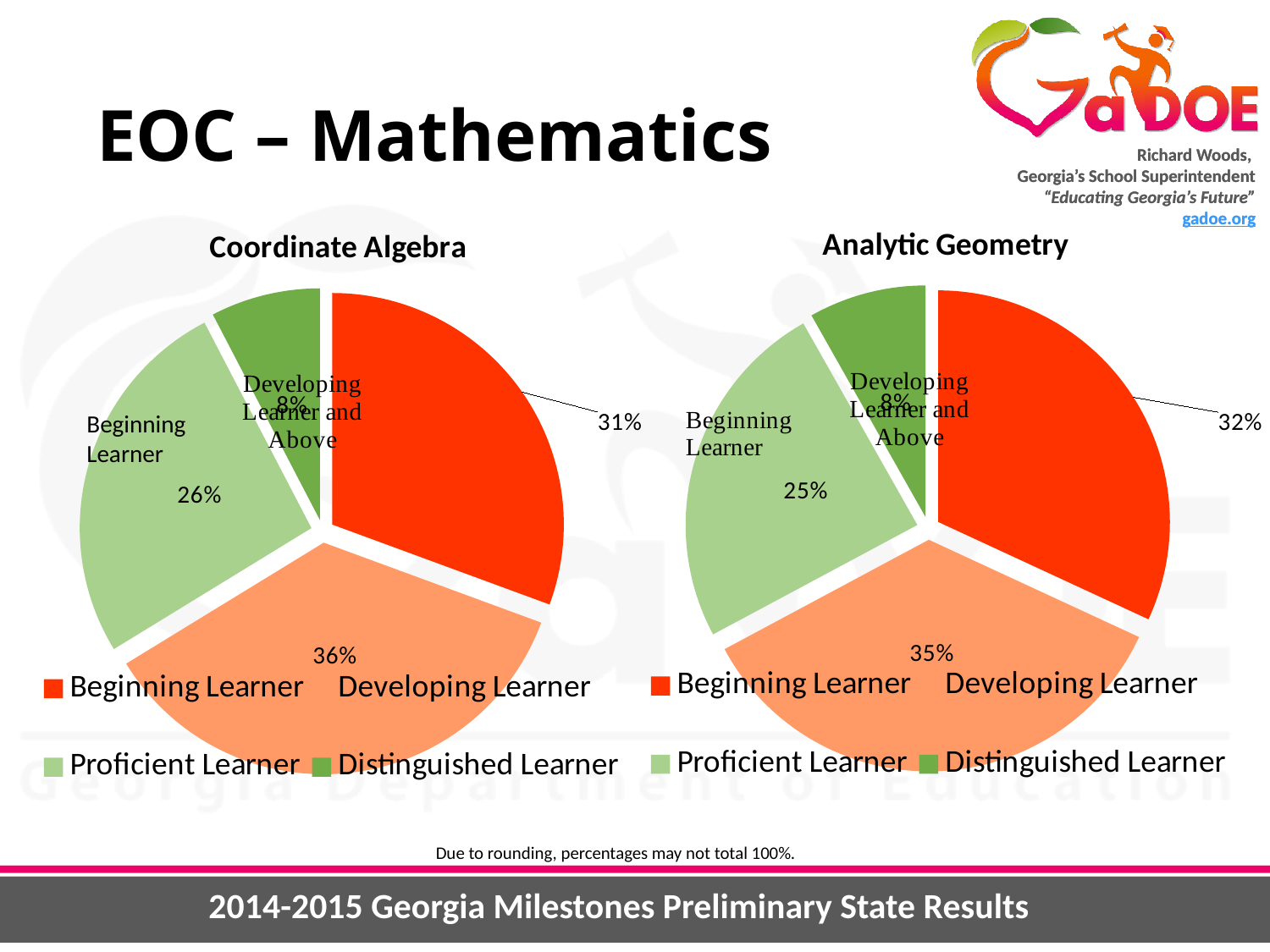
In the Coordinate Algebra chart, which category has the largest share? Developing Learner How many entries does the legend of the Coordinate Algebra chart list? 4 What type of chart is used for Coordinate Algebra? Pie chart How many categories does the Analytic Geometry chart show? 4 In the Coordinate Algebra chart, what is the difference between the Developing Learner and Proficient Learner percentages? 10% In the Analytic Geometry chart, what is the difference between the Beginning Learner and Distinguished Learner percentages? 24% In the Coordinate Algebra chart, what percentage of students are Developing Learners? 36% In the Analytic Geometry chart, what percentage of students are Distinguished Learners? 8% Which chart shows a higher percentage of Beginning Learners, Coordinate Algebra or Analytic Geometry? Analytic Geometry In the Analytic Geometry chart, which category has the smallest share? Distinguished Learner In the Coordinate Algebra chart, what percentage of students are Beginning Learners? 31% In the Analytic Geometry chart, what percentage of students are Proficient Learners? 25%